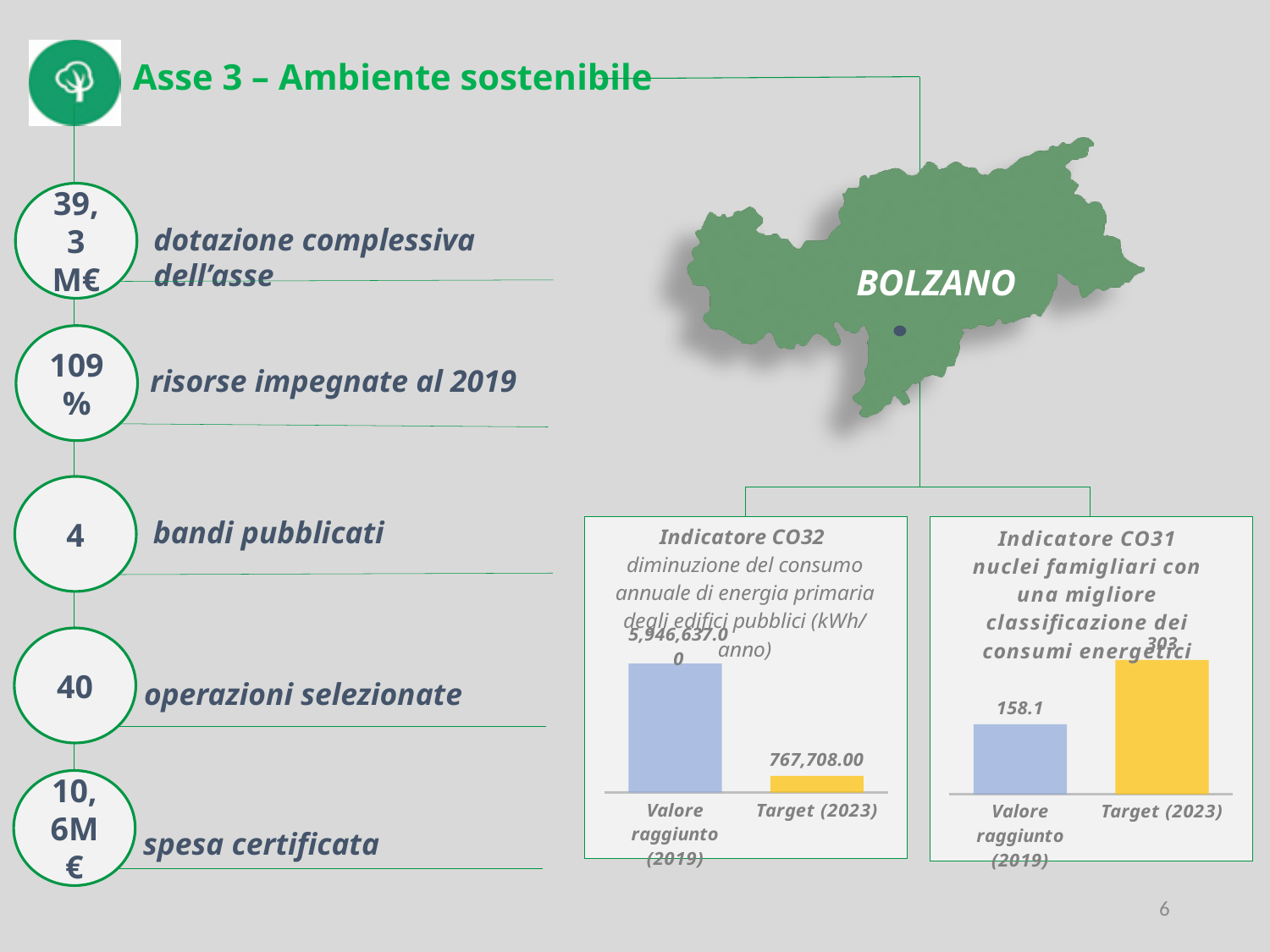
In the Indicatore CO31 chart, which category has the lowest value? Valore raggiunto (2019) In the Indicatore CO32 chart, what is the value for Target (2023)? 767,708.00 What is the title of the chart on the right of the slide? Indicatore CO31 nuclei famigliari con una migliore classificazione dei consumi energetici In the Indicatore CO32 chart, what colour is the Target (2023) bar? yellow In the Indicatore CO32 chart, what is the value for Valore raggiunto (2019)? 5,946,637.00 In the Indicatore CO31 chart, which is larger: Valore raggiunto (2019) or Target (2023)? Target (2023) In the Indicatore CO32 chart, which category has the higher value? Valore raggiunto (2019) In the Indicatore CO31 chart, what is the value for Target (2023)? 303 What kind of chart is the Indicatore CO32 chart? bar chart In the Indicatore CO32 chart, how many bars are plotted? 2 In the Indicatore CO31 chart, what is the difference between Target (2023) and Valore raggiunto (2019)? 144.9 In the Indicatore CO31 chart, what is the value for Valore raggiunto (2019)? 158.1